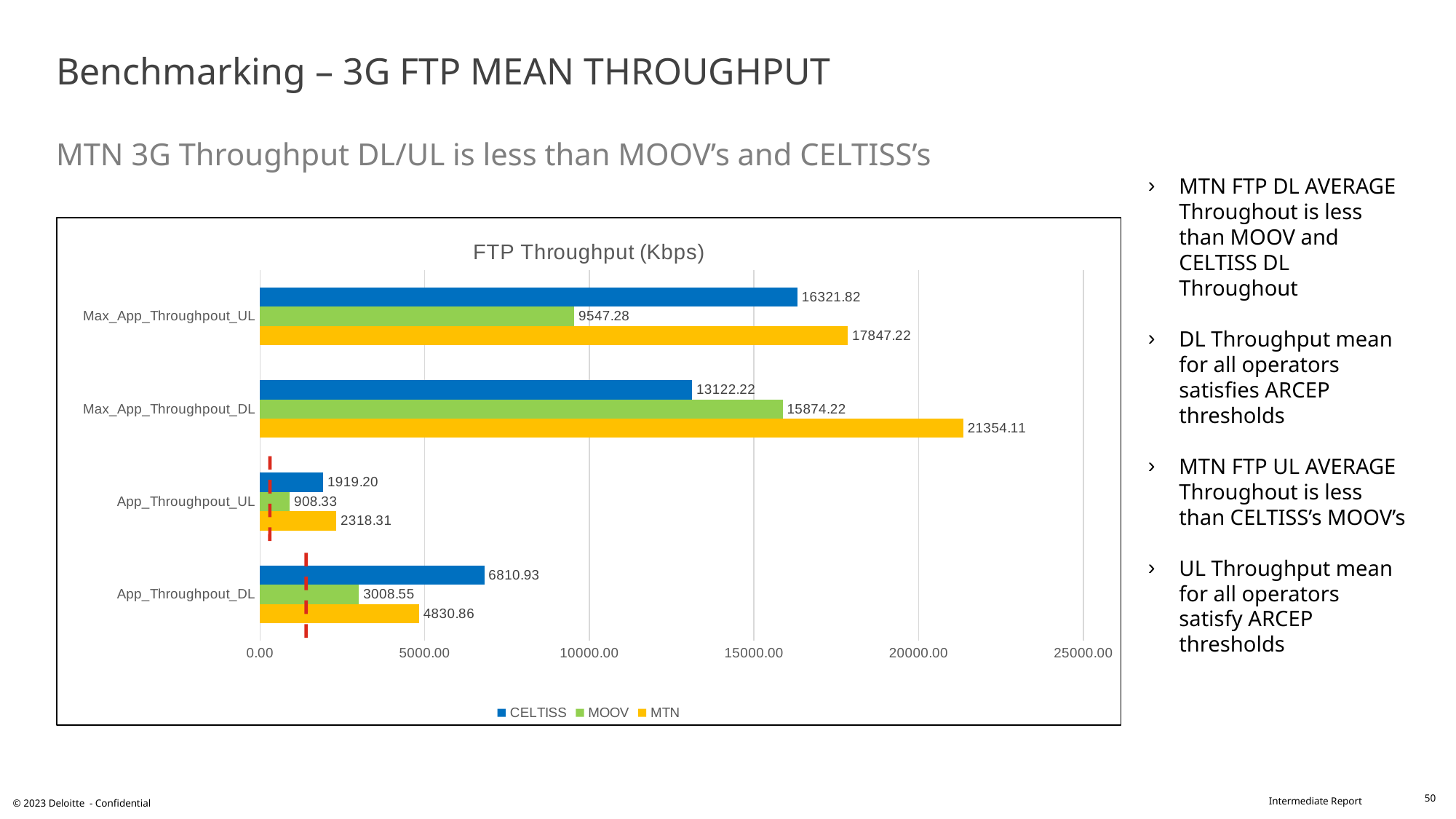
What kind of chart is shown on the slide? bar chart How many categories are shown on the y axis of the chart? 4 How many series does the legend list? 3 Is the MOOV value for Max_App_Throughpout_UL greater or less than 10000.00? less What is the MTN value for Max_App_Throughpout_DL? 21354.11 What is the CELTISS value for App_Throughpout_DL? 6810.93 Which operator has the lowest value for App_Throughpout_DL? MOOV What is the MOOV value for App_Throughpout_UL? 908.33 Which operator has the highest value for Max_App_Throughpout_UL? MTN What is the difference between the MTN and CELTISS values for Max_App_Throughpout_DL? 8231.89 What is the title of the chart? FTP Throughput (Kbps) Which is larger for App_Throughpout_UL: the CELTISS value or the MTN value? MTN